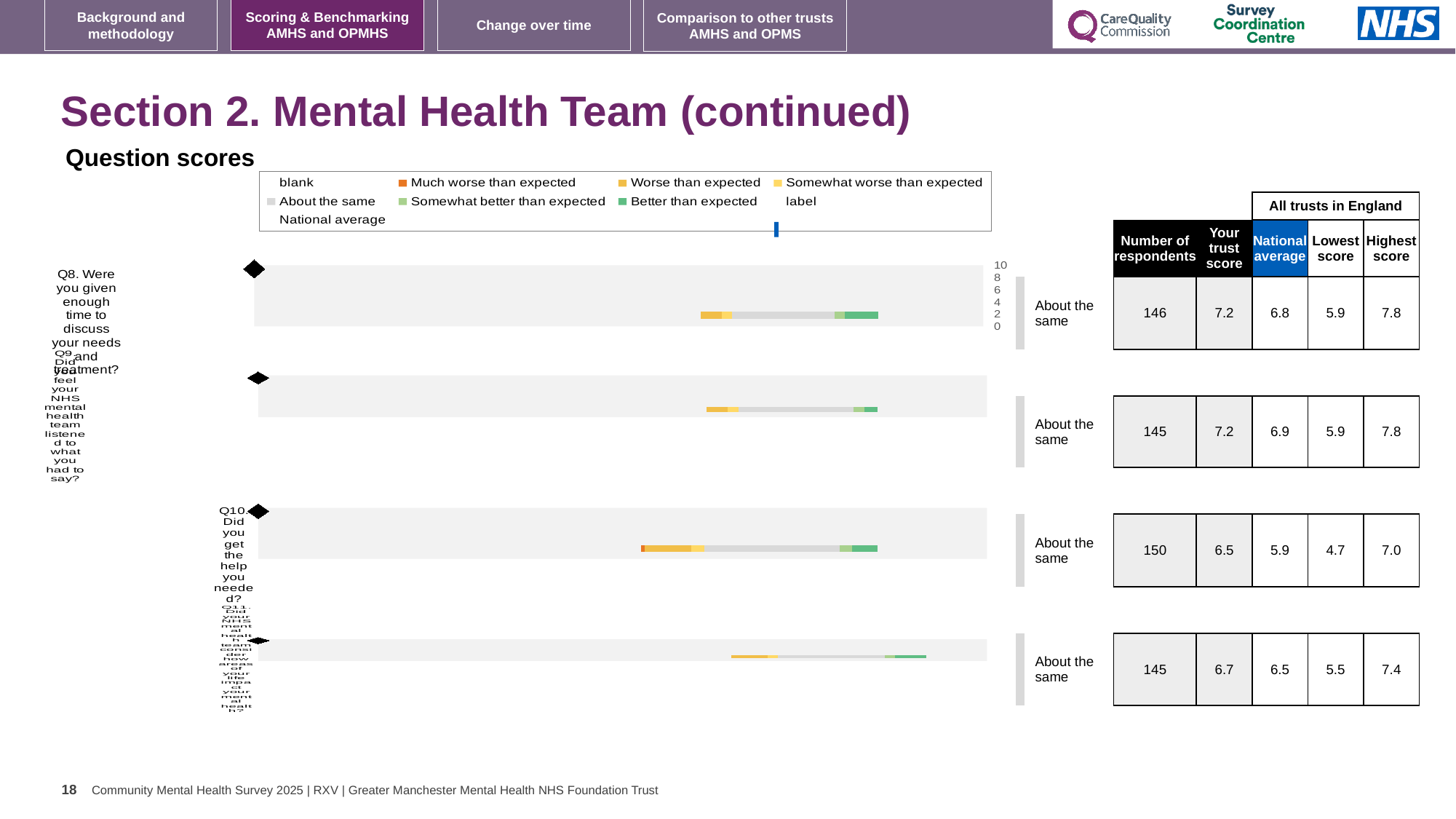
How many entries does the shared legend above the question-score charts list? 9 In the table beside the Q8 chart, what is the national average? 6.8 In the table beside the Q11 chart, how many respondents are listed? 145 What is the difference between the trust score and the national average for Q10 in the table beside the chart? 0.6 What kind of chart is used for the question scores on this slide? bar chart What is the highest tick value shown on the axis of the question-score charts? 10 In the table beside the Q10 chart, what is the trust's score? 6.5 Which question (Q8, Q9, Q10 or Q11) has the lowest trust score in the tables beside the charts? Q10 What benchmark category is printed next to the Q8 chart? About the same What colour represents 'Better than expected' in the legend of the question-score charts? green How many question-score charts (Q8 to Q11) are shown on the slide? 4 What colour represents 'About the same' in the legend of the question-score charts? grey